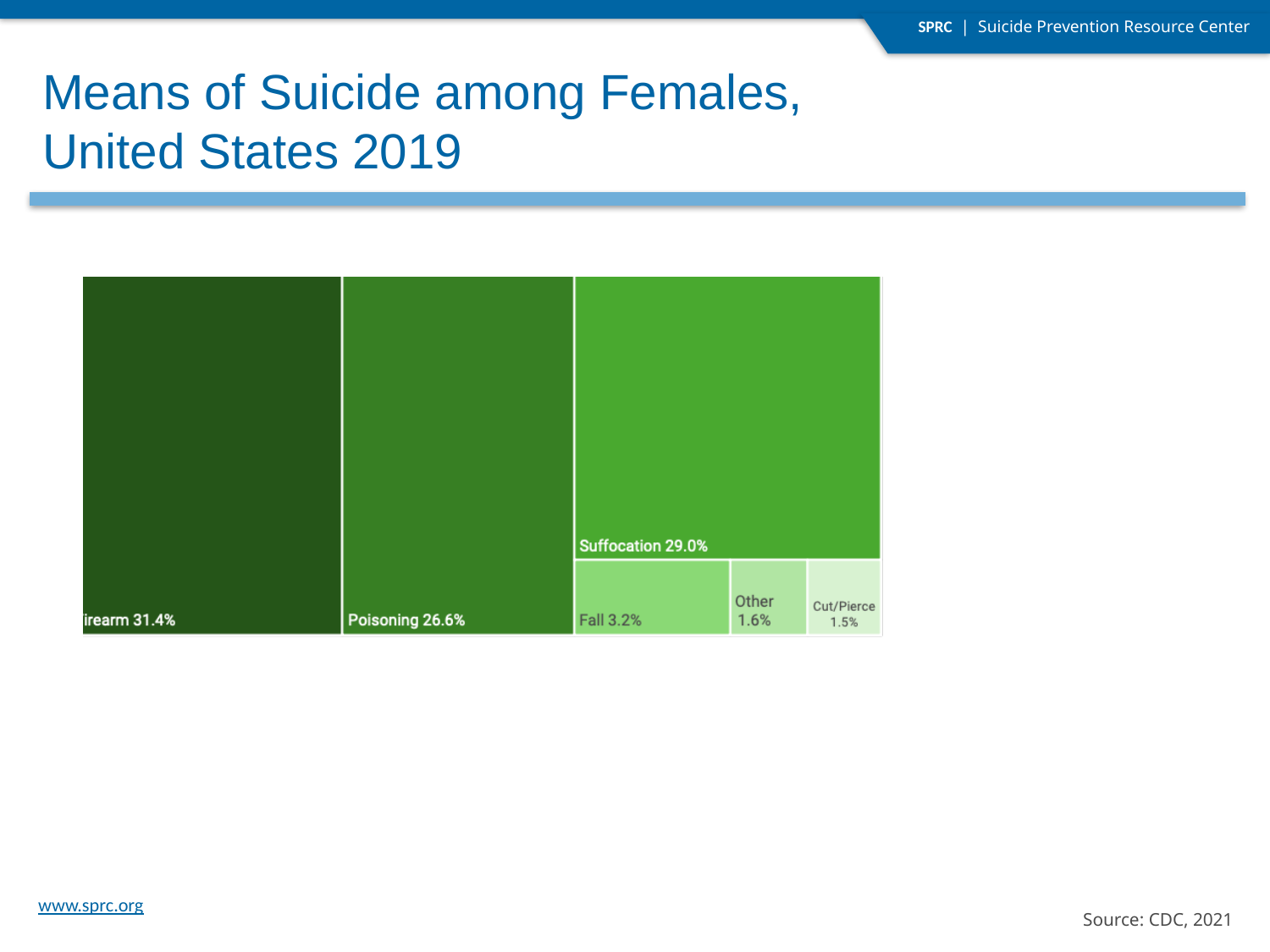
Which means of suicide has the highest percentage in the chart? Firearm What kind of chart is shown on the slide? Treemap What percentage is shown for Poisoning? 26.6% Which means of suicide has the lowest percentage in the chart? Cut/Pierce What percentage of suicides among females in the United States in 2019 were by firearm? 31.4% What is the difference in percentage points between Firearm and Poisoning? 4.8 Which is larger, the percentage for Suffocation or for Poisoning? Suffocation What is the difference in percentage points between Suffocation and Poisoning? 2.4 What percentage is shown for Suffocation? 29.0% What percentage is shown for Fall? 3.2% How many means of suicide categories are shown in the chart? 6 What percentage is shown for Cut/Pierce? 1.5%